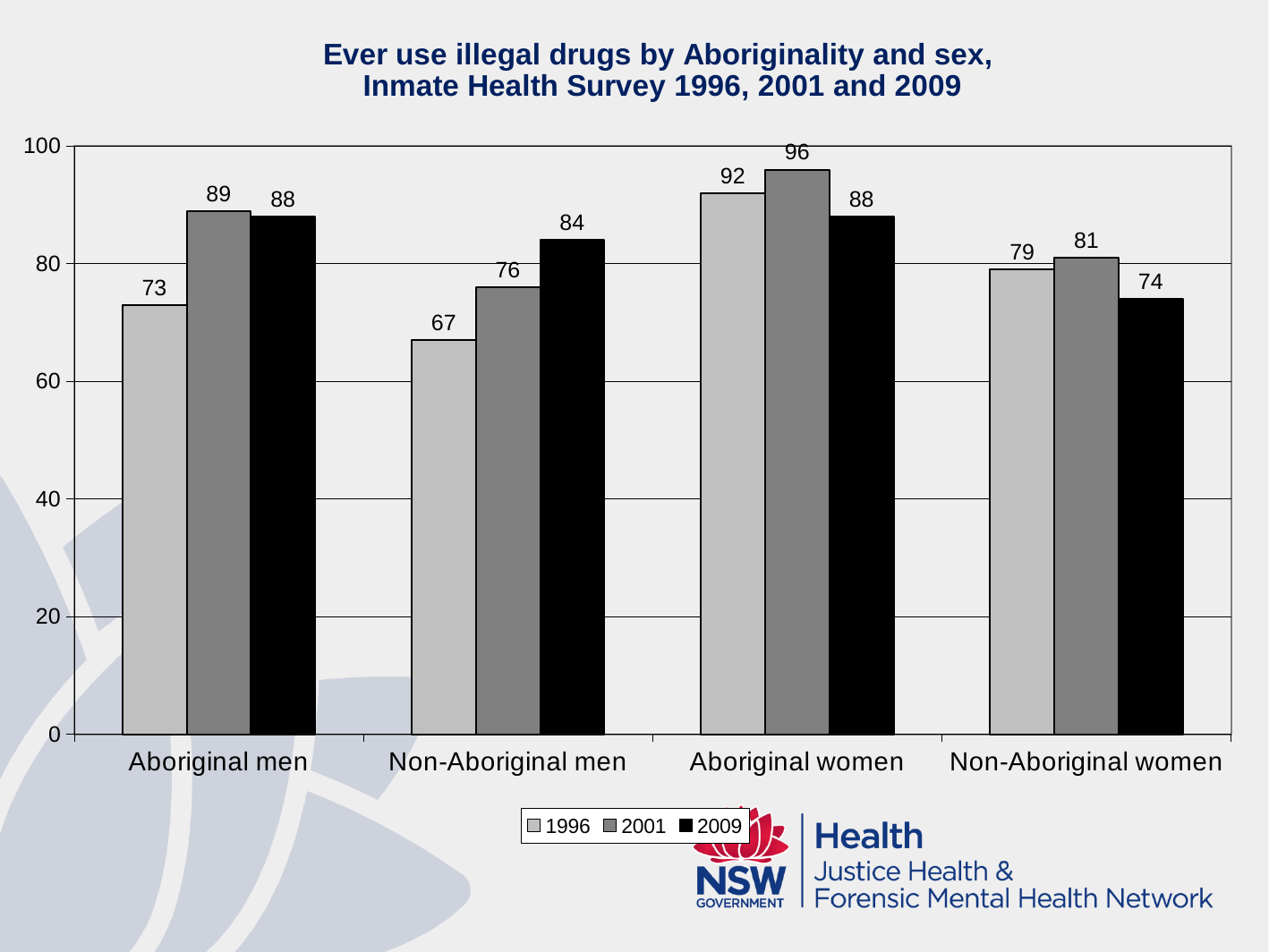
What is the difference between the 2009 and 1996 values for Non-Aboriginal men? 17 What kind of chart is shown on the slide? Bar chart Do the values for Aboriginal women rise or fall from 2001 to 2009? Fall What is the value for Aboriginal men in 1996? 73 Which category has the highest value in the 2001 series? Aboriginal women Which category has the lowest value in the 1996 series? Non-Aboriginal men What is the value for Aboriginal women in 2001? 96 Which series is shown in black in the legend? 2009 How many series does the legend list? 3 Which is larger for Non-Aboriginal women: the 2001 value or the 2009 value? 2001 How many categories are shown on the x axis? 4 What is the value for Non-Aboriginal women in 2009? 74